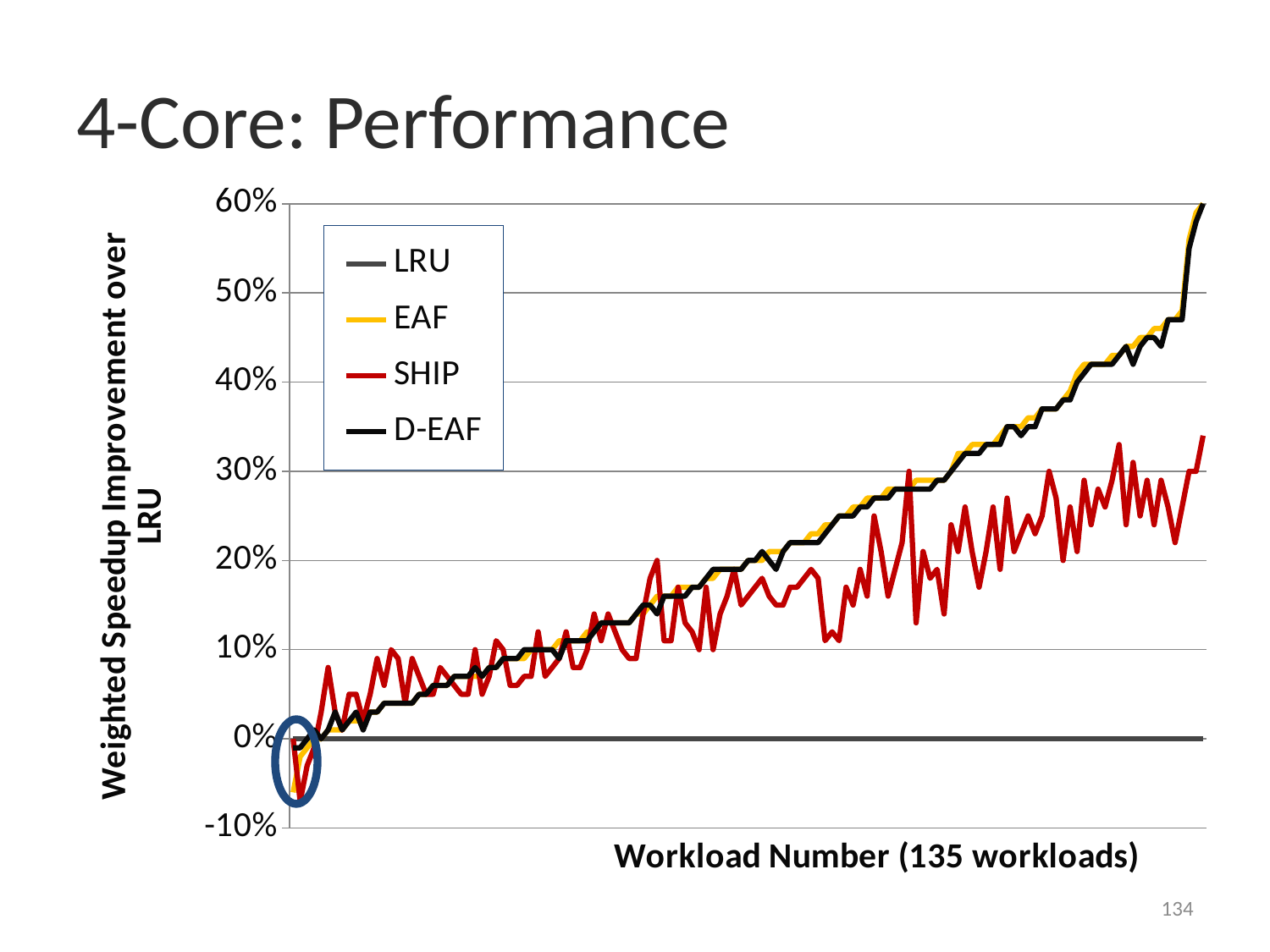
Which series reaches the highest value on the chart, SHIP or EAF? EAF What kind of chart is shown on the slide? line chart What is the title of the x axis? Workload Number (135 workloads) Is the D-EAF value for the last workload greater or less than 50%? greater At the rightmost workload, which series has the higher value, D-EAF or SHIP? D-EAF How many workloads are plotted along the x axis? 135 Is the lowest SHIP value greater or less than 0%? less Is the highest SHIP value greater or less than 40%? less Which series are listed in the legend? LRU, EAF, SHIP, D-EAF What value does the LRU line stay at across all workloads? 0% Do the D-EAF values rise or fall as the workload number increases? rise How many series does the legend list? 4